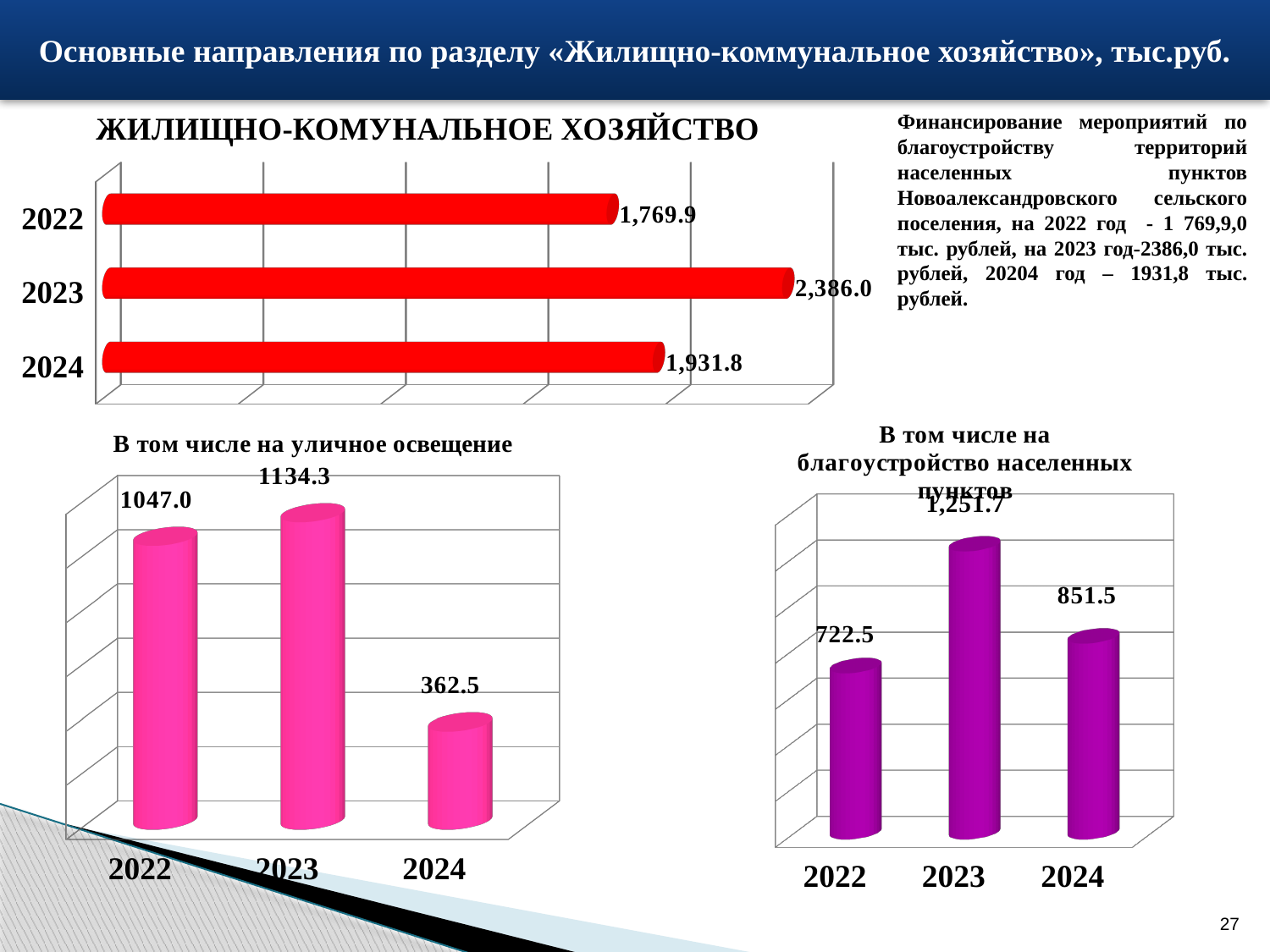
In the chart titled «В том числе на благоустройство населенных пунктов», what is the value for 2022? 722.5 In the chart titled «ЖИЛИЩНО-КОМУНАЛЬНОЕ ХОЗЯЙСТВО», what is the difference between the 2023 and 2022 values? 616.1 In the chart titled «В том числе на благоустройство населенных пунктов», which is larger, the value for 2022 or the value for 2024? 2024 How many years are shown in the chart titled «В том числе на уличное освещение»? 3 In the chart titled «В том числе на уличное освещение», what is the difference between the 2023 and 2024 values? 771.8 What colour are the bars in the chart titled «В том числе на благоустройство населенных пунктов»? Purple In the chart titled «В том числе на уличное освещение», what is the value for 2024? 362.5 In the chart titled «ЖИЛИЩНО-КОМУНАЛЬНОЕ ХОЗЯЙСТВО», which year has the lowest value? 2022 In the chart titled «В том числе на уличное освещение», which year has the highest value? 2023 What kind of chart is the one titled «ЖИЛИЩНО-КОМУНАЛЬНОЕ ХОЗЯЙСТВО»? Bar chart In the chart titled «ЖИЛИЩНО-КОМУНАЛЬНОЕ ХОЗЯЙСТВО», what is the value for 2023? 2,386.0 In the chart titled «В том числе на благоустройство населенных пунктов», what is the difference between the 2023 and 2022 values? 529.2